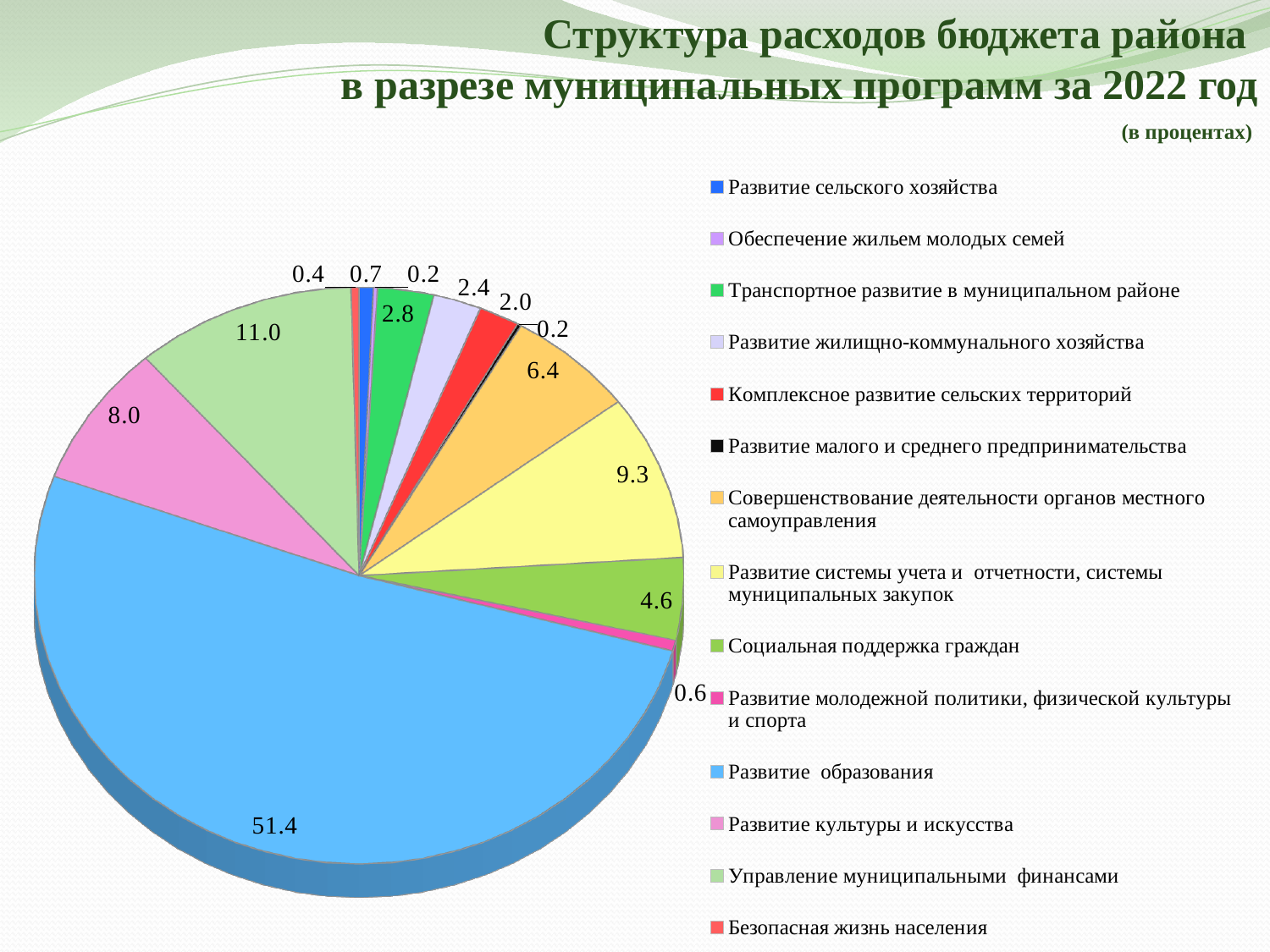
What is the share for Управление муниципальными финансами? 11.0 What is the share for Развитие образования? 51.4 What is the difference between the shares for Управление муниципальными финансами and Развитие культуры и искусства? 3.0 What is the share for Развитие системы учета и отчетности, системы муниципальных закупок? 9.3 Which program has the largest share of the budget expenditures? Развитие образования In what units are the values on the chart expressed, according to the subtitle? в процентах What is the share for Социальная поддержка граждан? 4.6 What is the difference between the shares for Развитие системы учета и отчетности, системы муниципальных закупок and Социальная поддержка граждан? 4.7 What kind of chart is shown on the slide? pie chart What is the share for Совершенствование деятельности органов местного самоуправления? 6.4 How many slices does the pie chart have? 14 Which has a larger share: Транспортное развитие в муниципальном районе or Комплексное развитие сельских территорий? Транспортное развитие в муниципальном районе